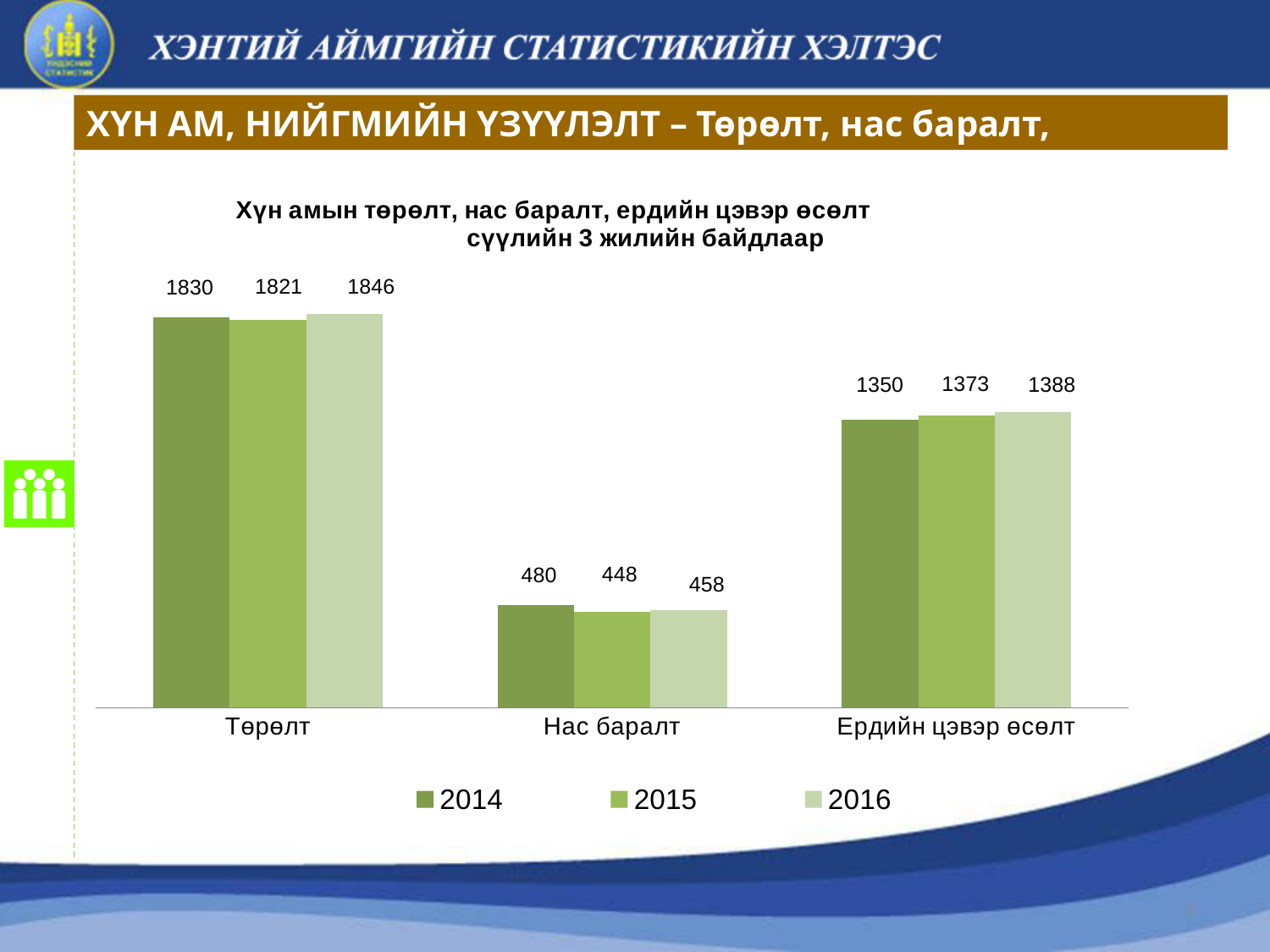
Which category has the lowest values across all years? Нас баралт How many categories are shown on the x axis? 3 What is the value for Ердийн цэвэр өсөлт in 2014? 1350 What is the difference between Төрөлт and Нас баралт in 2015? 1373 How many series does the legend list? 3 What kind of chart is shown on the slide? Bar chart Do the values for Ердийн цэвэр өсөлт rise or fall from 2014 to 2016? Rise What is the value for Нас баралт in 2015? 448 Which is larger: Нас баралт in 2014 or Нас баралт in 2016? Нас баралт in 2014 Which category has the highest value in 2016? Төрөлт What is the value for Төрөлт in 2016? 1846 What is the difference between the 2016 and 2014 values for Ердийн цэвэр өсөлт? 38